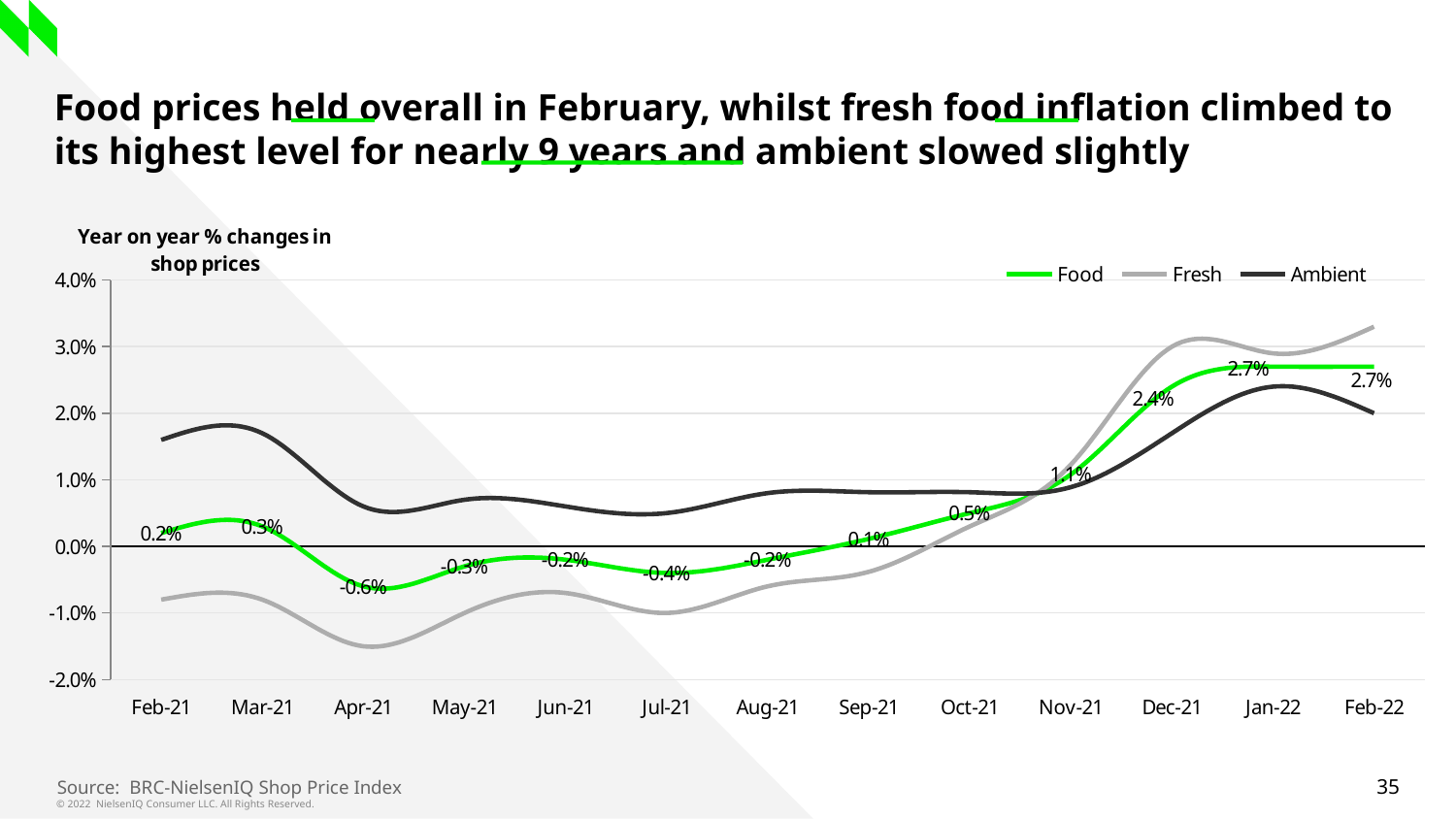
What is the Food value for Apr-21? -0.6% What is the Food value for Dec-21? 2.4% Which is larger for the Food series: the value for Oct-21 or the value for Sep-21? Oct-21 What is the Food value for Nov-21? 1.1% What is the difference between the Food values for Dec-21 and Nov-21? 1.3% How many months are shown on the x axis? 13 In which month is the Food series at its lowest value? Apr-21 Is the Fresh value for Feb-22 greater or less than 3.0%? greater What kind of chart is shown on the slide? Line chart Is the Ambient value for Feb-21 greater or less than 1.0%? greater Does the Food series rise or fall between Sep-21 and Jan-22? Rise How many series does the legend list? 3